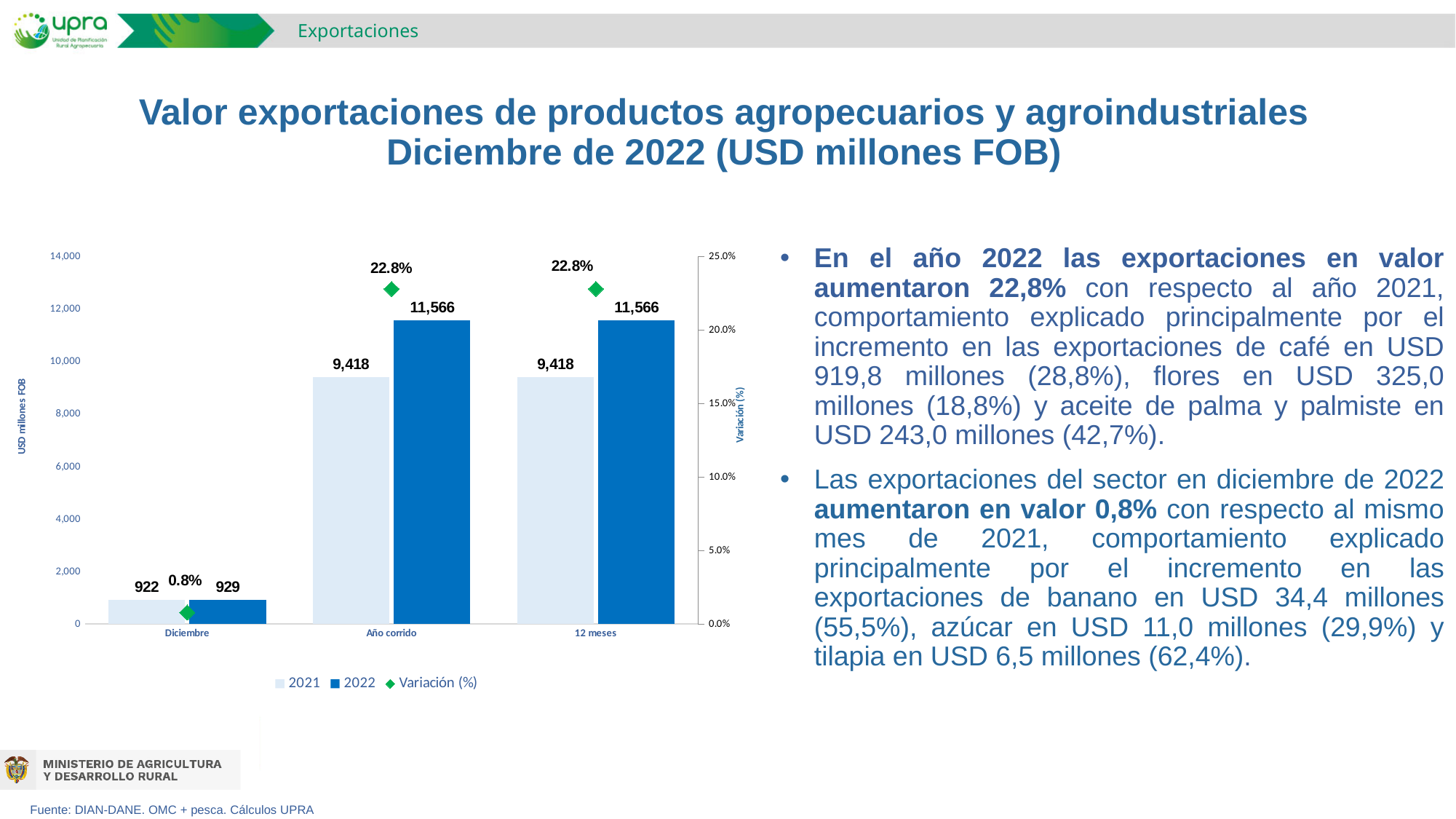
How many categories are shown on the x axis? 3 What is the 2022 value for 12 meses? 11,566 Which category has the lowest 2022 value? Diciembre What is the 2021 value for Año corrido? 9,418 What is the Variación (%) value for Diciembre? 0.8% What kind of chart is shown on the slide? Bar chart with a line/marker series How many series does the legend list? 3 What is the difference between the 2022 and 2021 values for Diciembre? 7 What is the Variación (%) value for Año corrido? 22.8% Which is larger for 12 meses, the 2021 value or the 2022 value? 2022 What is the 2022 value for Diciembre? 929 What is the difference between the 2022 and 2021 values for Año corrido? 2,148